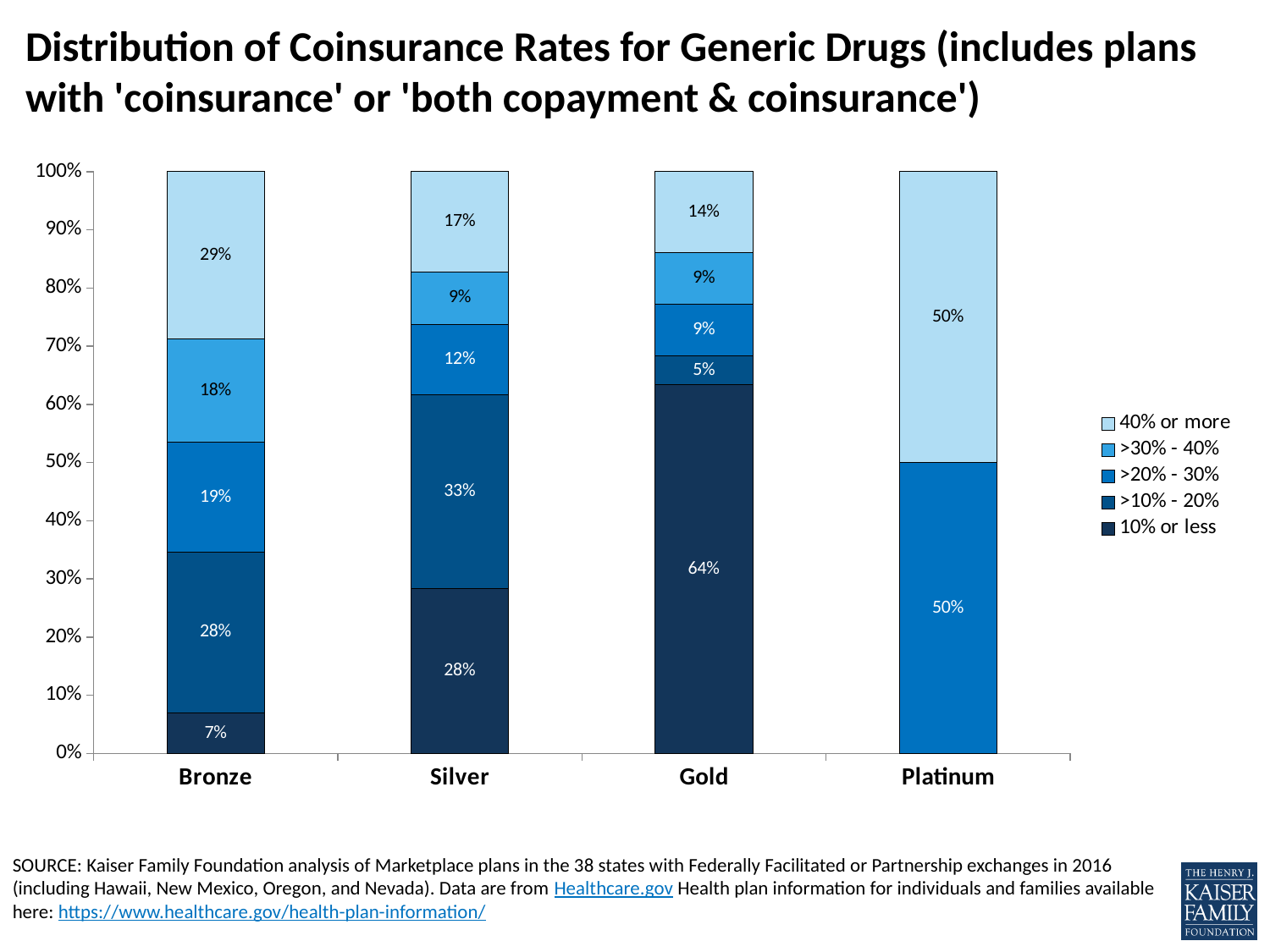
What type of chart is shown on the slide? Stacked bar chart How many coinsurance bands does the legend list? 5 Which metal level has the largest share of plans with a coinsurance rate of 10% or less? Gold What is the difference between the share of Gold plans and the share of Silver plans with a coinsurance rate of 10% or less? 36 percentage points What share of Platinum plans have a coinsurance rate of 40% or more? 50% What share of Gold plans have a generic drug coinsurance rate of 10% or less? 64% How many metal levels are shown on the x axis? 4 Which is larger: the share of Bronze plans with a coinsurance rate of 40% or more, or the share of Silver plans with a coinsurance rate of 40% or more? Bronze What share of Bronze plans have a generic drug coinsurance rate of 40% or more? 29% Which legend entry is shown in the lightest blue? 40% or more What share of Silver plans fall in the >10% - 20% coinsurance band? 33%